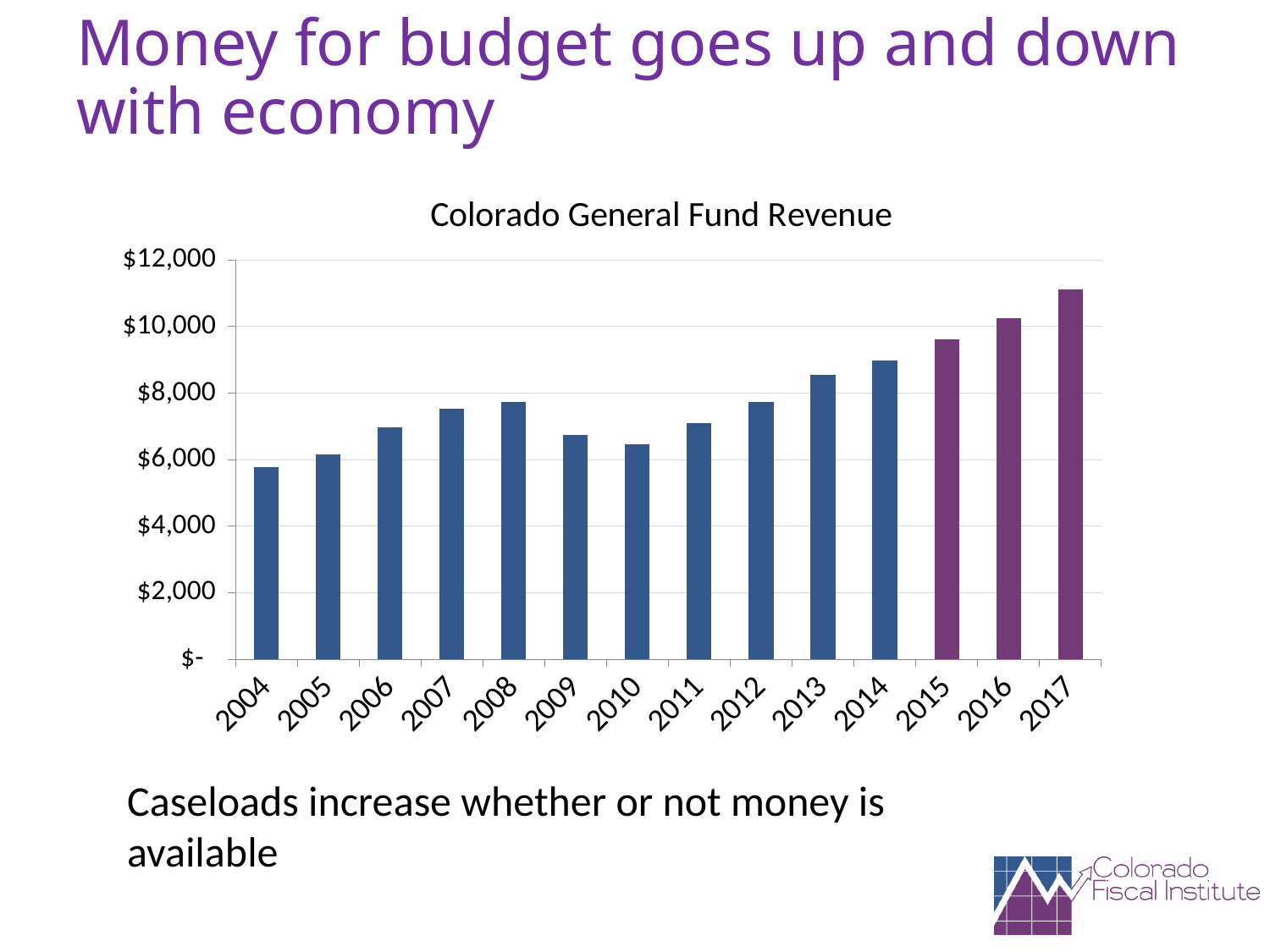
How many years are plotted on the x axis of the chart? 14 What is the title of the chart? Colorado General Fund Revenue Which year has the larger value, 2007 or 2010? 2007 Is the value for 2004 greater or less than $6,000? less Do the values rise or fall from 2008 to 2010? fall Is the value for 2016 greater or less than $10,000? greater Is the value for 2013 greater or less than $8,000? greater Which year has the highest General Fund Revenue? 2017 Which years are shown with purple bars instead of blue? 2015, 2016, 2017 Which year has the lowest General Fund Revenue? 2004 What kind of chart is shown on the slide? bar chart